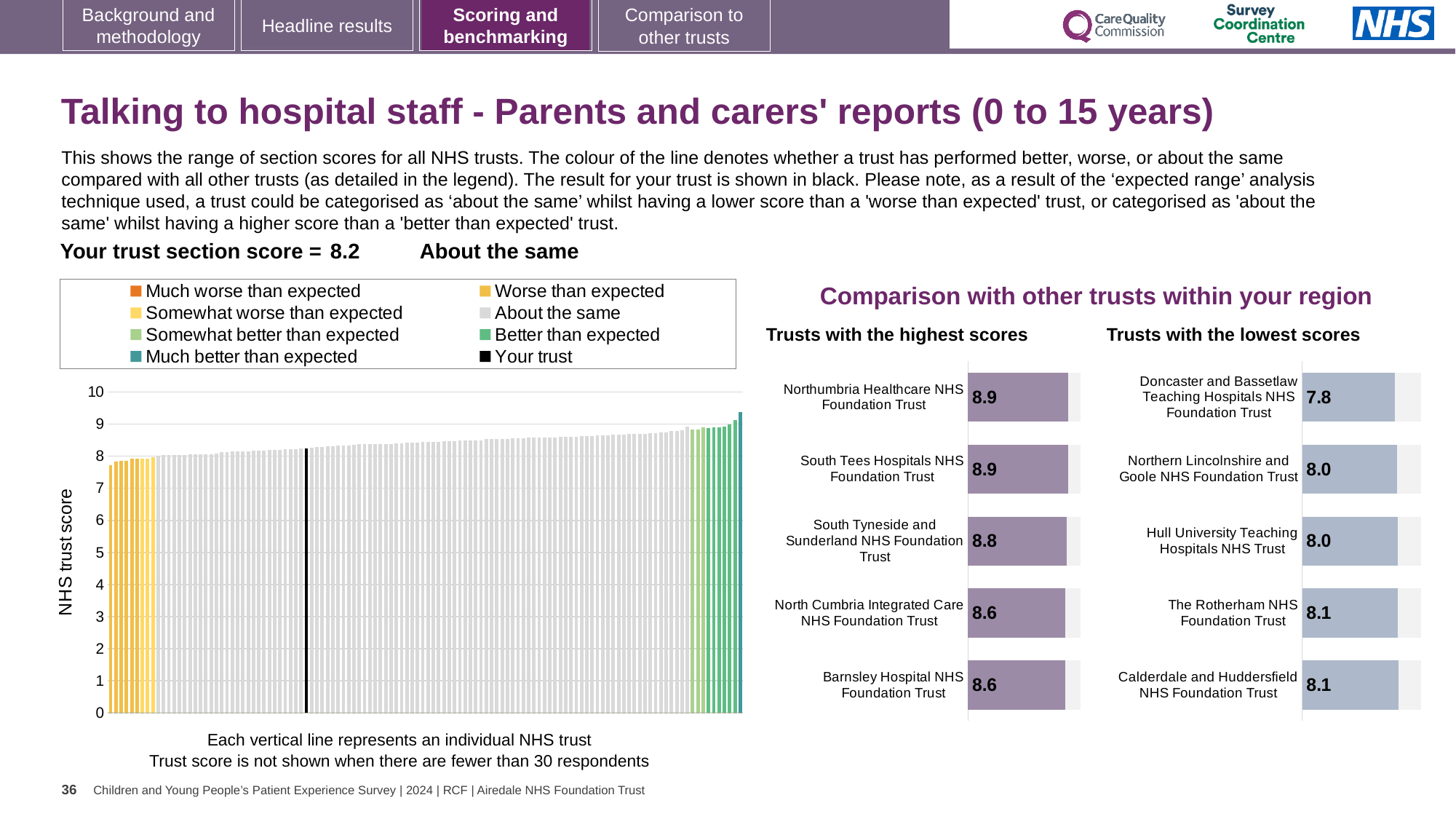
In the large chart on the left, do the trust scores rise or fall from left to right? Rise In the 'Trusts with the lowest scores' chart, what is the score for The Rotherham NHS Foundation Trust? 8.1 How many trusts are listed in the 'Trusts with the highest scores' chart? 5 In the 'Trusts with the highest scores' chart, what is the score for Northumbria Healthcare NHS Foundation Trust? 8.9 In the 'Trusts with the highest scores' chart, what is the difference between the scores of Northumbria Healthcare NHS Foundation Trust and Barnsley Hospital NHS Foundation Trust? 0.3 In the 'Trusts with the lowest scores' chart, which trust has the lowest score? Doncaster and Bassetlaw Teaching Hospitals NHS Foundation Trust In the 'Trusts with the lowest scores' chart, which has the larger score: Doncaster and Bassetlaw Teaching Hospitals NHS Foundation Trust or The Rotherham NHS Foundation Trust? The Rotherham NHS Foundation Trust In the 'Trusts with the lowest scores' chart, what is the score for Doncaster and Bassetlaw Teaching Hospitals NHS Foundation Trust? 7.8 How many entries does the legend of the large chart on the left list? 8 What type of chart is the large chart on the left showing NHS trust scores? Bar chart In the large chart on the left, is the value of the tallest bar at the far right greater or less than 9? greater In the 'Trusts with the highest scores' chart, what is the score for South Tyneside and Sunderland NHS Foundation Trust? 8.8